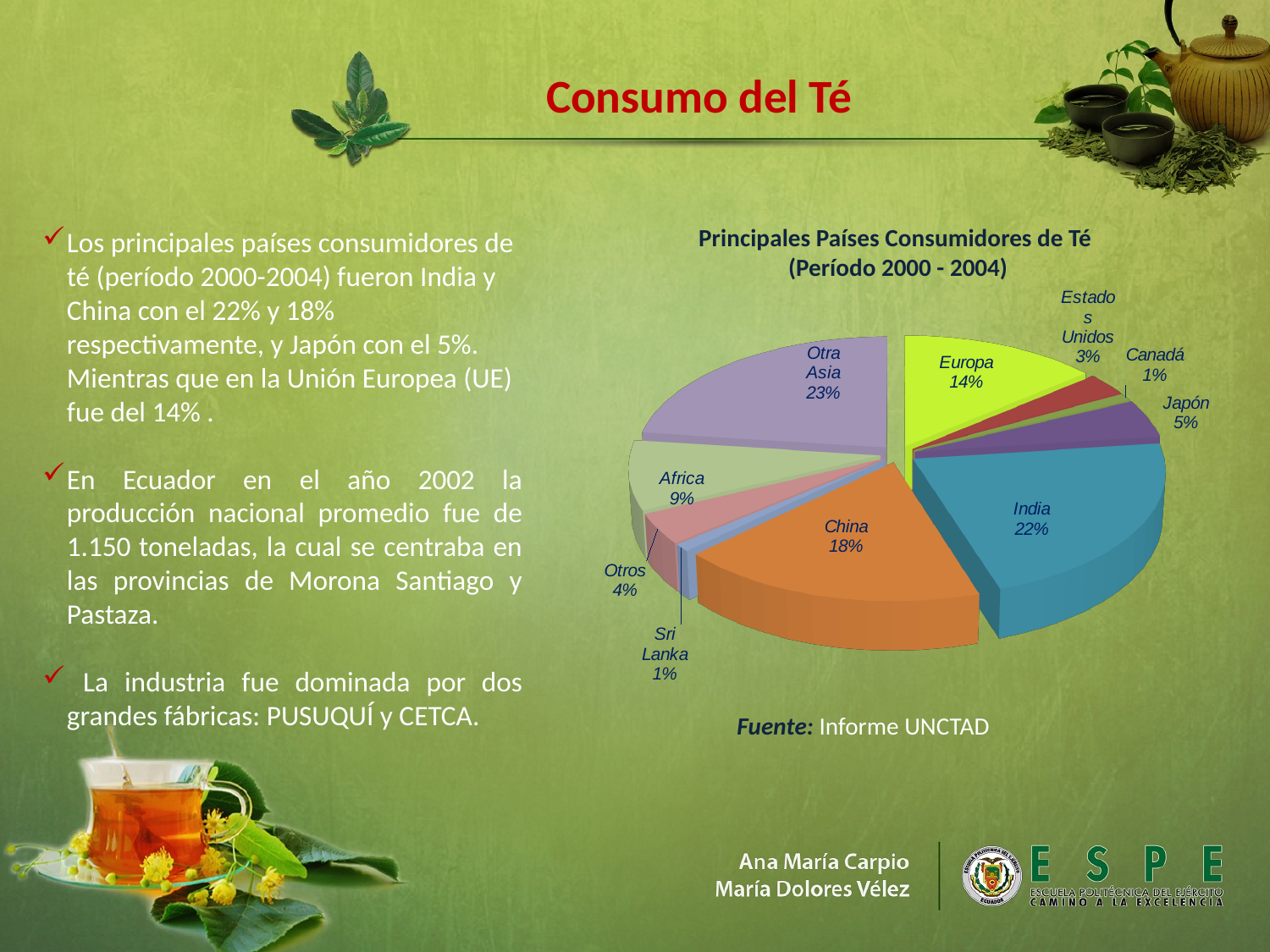
What share of the pie does India have? 22% What is the title of the chart? Principales Países Consumidores de Té (Período 2000 - 2004) What percentage is shown for Japón? 5% What is the difference between the shares of India and China? 4% What kind of chart is shown on the slide? pie chart What share of the pie does China have? 18% Which slice has the largest share of the pie? Otra Asia What source is cited below the chart? Informe UNCTAD What percentage is shown for Africa? 9% Which has a larger share, Europa or Africa? Europa What percentage is shown for Europa? 14% How many slices does the pie chart have? 10